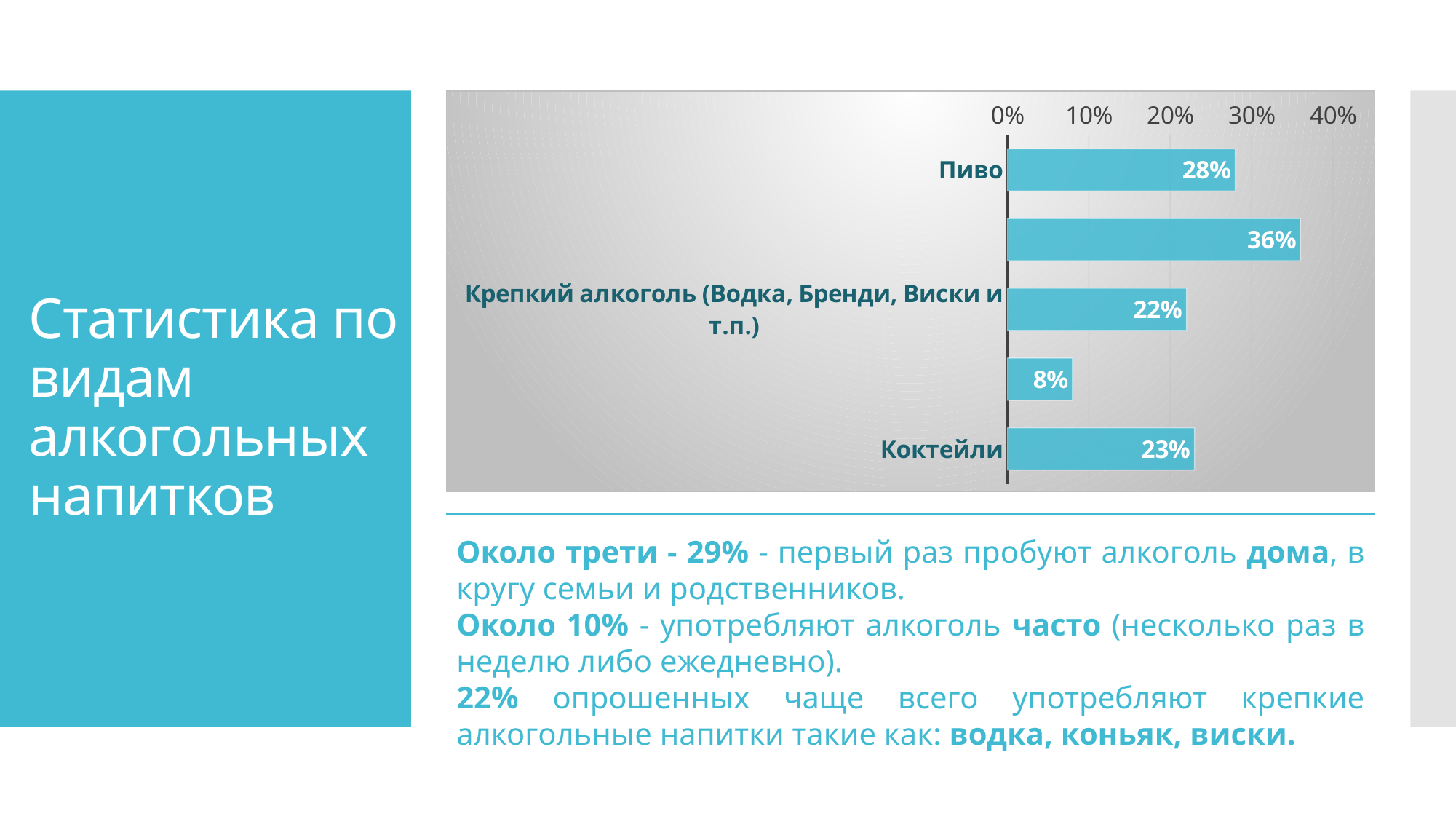
What kind of chart is shown on the slide? bar chart What is the value for Крепкий алкоголь (Водка, Бренди, Виски и т.п.)? 22% What is the value for Коктейли? 23% What is the difference between the values for Пиво and Коктейли? 5% What is the highest tick value shown on the chart's axis? 40% What is the highest value shown on the chart? 36% What is the difference between the values for Пиво and Крепкий алкоголь? 6% What is the value for Пиво? 28% How many bars are plotted on the chart? 5 What is the lowest value shown on the chart? 8% Which is larger, the value for Пиво or the value for Коктейли? Пиво Is the value for Пиво greater or less than 20%? greater